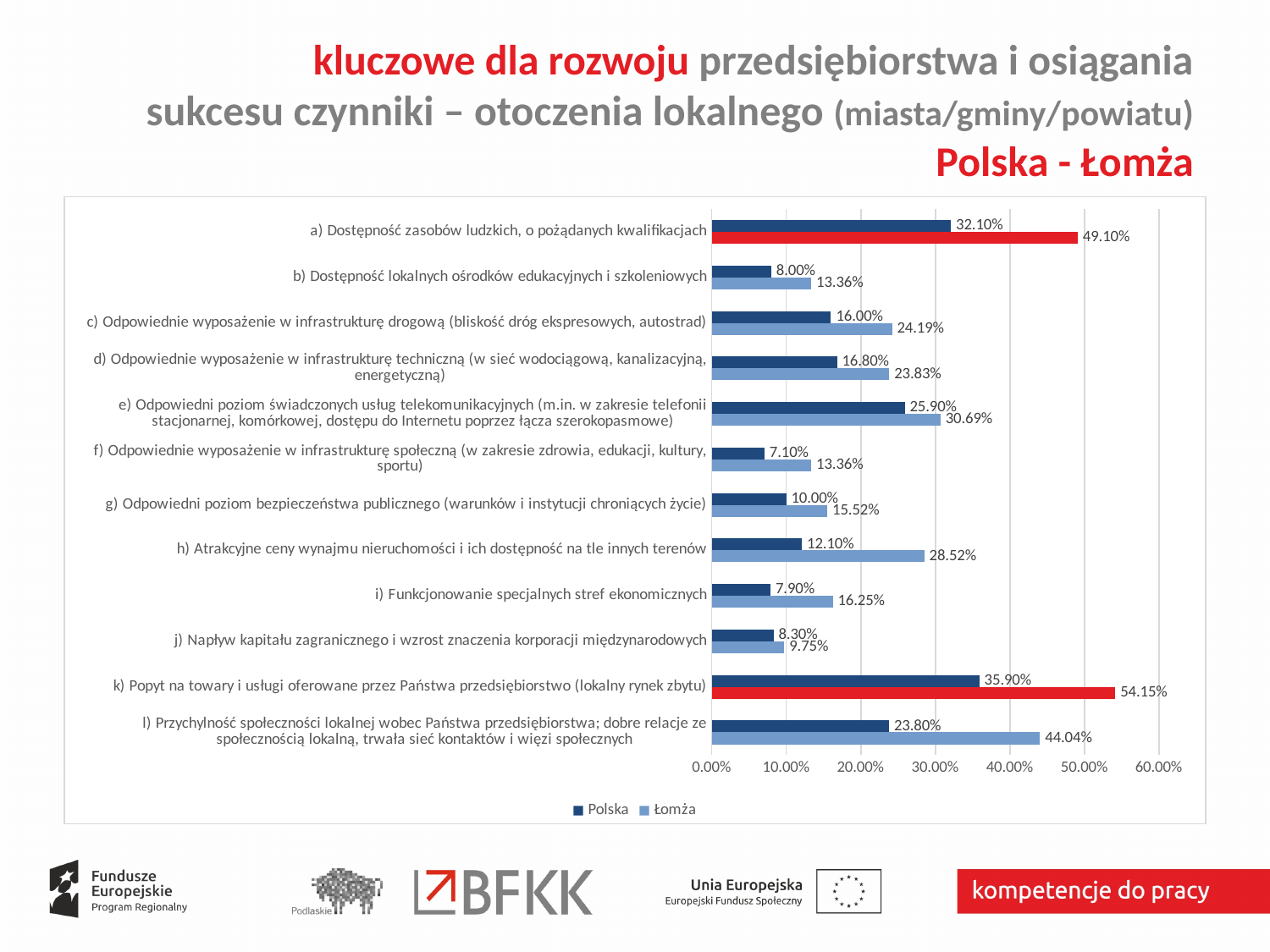
What kind of chart is shown on the slide? Bar chart Which category has the lowest Polska value? f) Odpowiednie wyposażenie w infrastrukturę społeczną (w zakresie zdrowia, edukacji, kultury, sportu) Which category has the highest Łomża value? k) Popyt na towary i usługi oferowane przez Państwa przedsiębiorstwo (lokalny rynek zbytu) How many series does the legend list? 2 What is the Łomża value for category k) Popyt na towary i usługi oferowane przez Państwa przedsiębiorstwo (lokalny rynek zbytu)? 54.15% What is the Polska value for category a) Dostępność zasobów ludzkich, o pożądanych kwalifikacjach? 32.10% Which category has the lowest Łomża value? j) Napływ kapitału zagranicznego i wzrost znaczenia korporacji międzynarodowych What is the difference between the Łomża and Polska values for category k) Popyt na towary i usługi oferowane przez Państwa przedsiębiorstwo (lokalny rynek zbytu)? 18.25 percentage points For category l) Przychylność społeczności lokalnej wobec Państwa przedsiębiorstwa, which is larger: the Polska value or the Łomża value? Łomża What is the difference between the Łomża and Polska values for category a) Dostępność zasobów ludzkich, o pożądanych kwalifikacjach? 17.00 percentage points How many categories are shown in the chart? 12 What is the Łomża value for category h) Atrakcyjne ceny wynajmu nieruchomości i ich dostępność na tle innych terenów? 28.52%